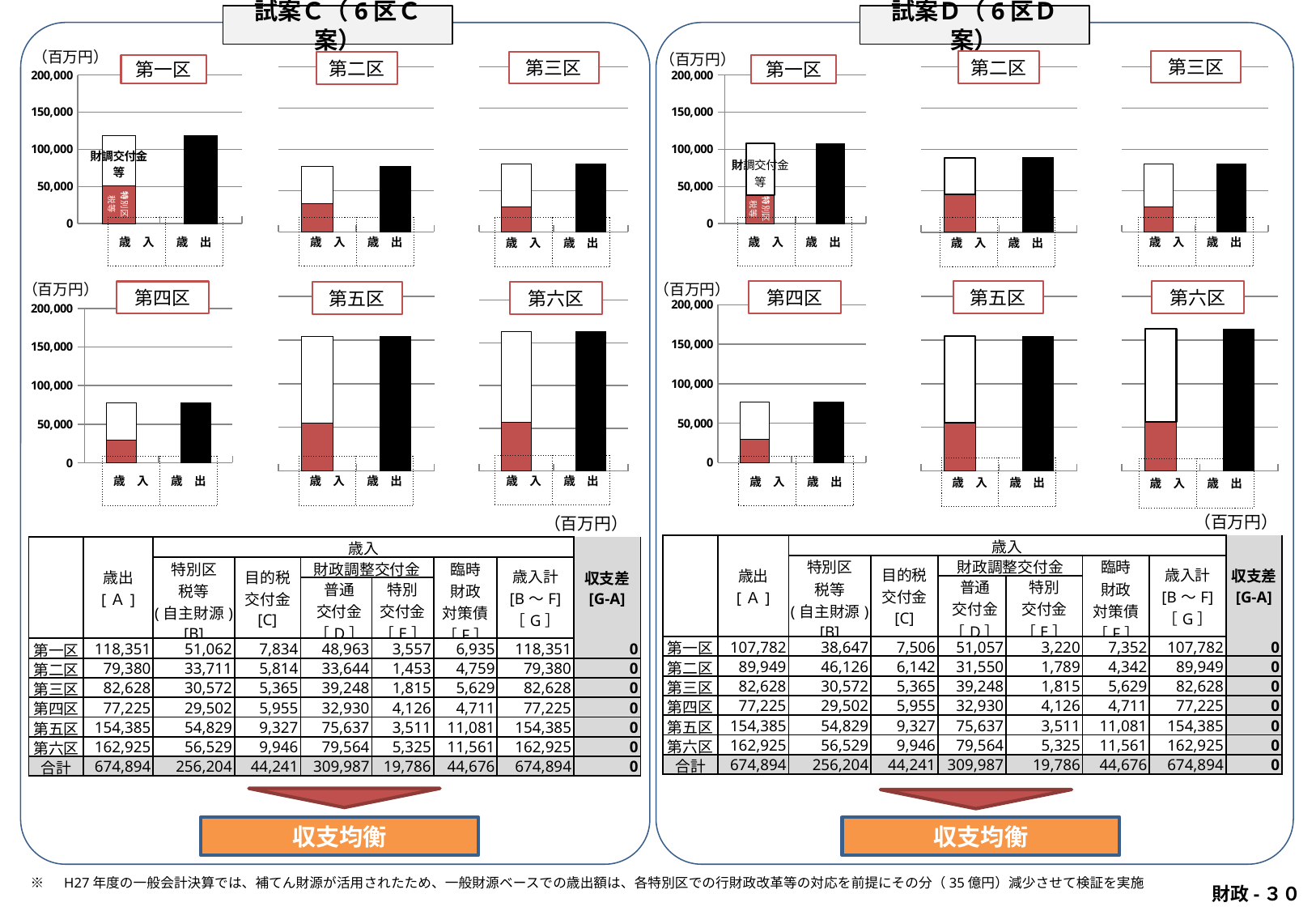
How many categories are shown on the x axis of the 第一区 chart under 試案C? 2 In the 第一区 chart under 試案C, what label is given to the white segment of the 歳入 bar? 財調交付金等 In the 第六区 chart under 試案D, is the value for 歳出 greater or less than 150,000? greater What kind of chart is used for 第一区 under 試案C? bar chart In the 第五区 chart under 試案C, is the value for 歳出 greater or less than 100,000? greater In the 第四区 chart under 試案D, is the value for 歳出 greater or less than 100,000? less What unit is shown above the y axis of the charts? 百万円 How many district charts are shown under 試案D? 6 Under 試案C, which has the larger 歳出 bar: 第一区 or 第二区? 第一区 Under 試案D, which has the larger 歳出 bar: 第一区 or 第四区? 第一区